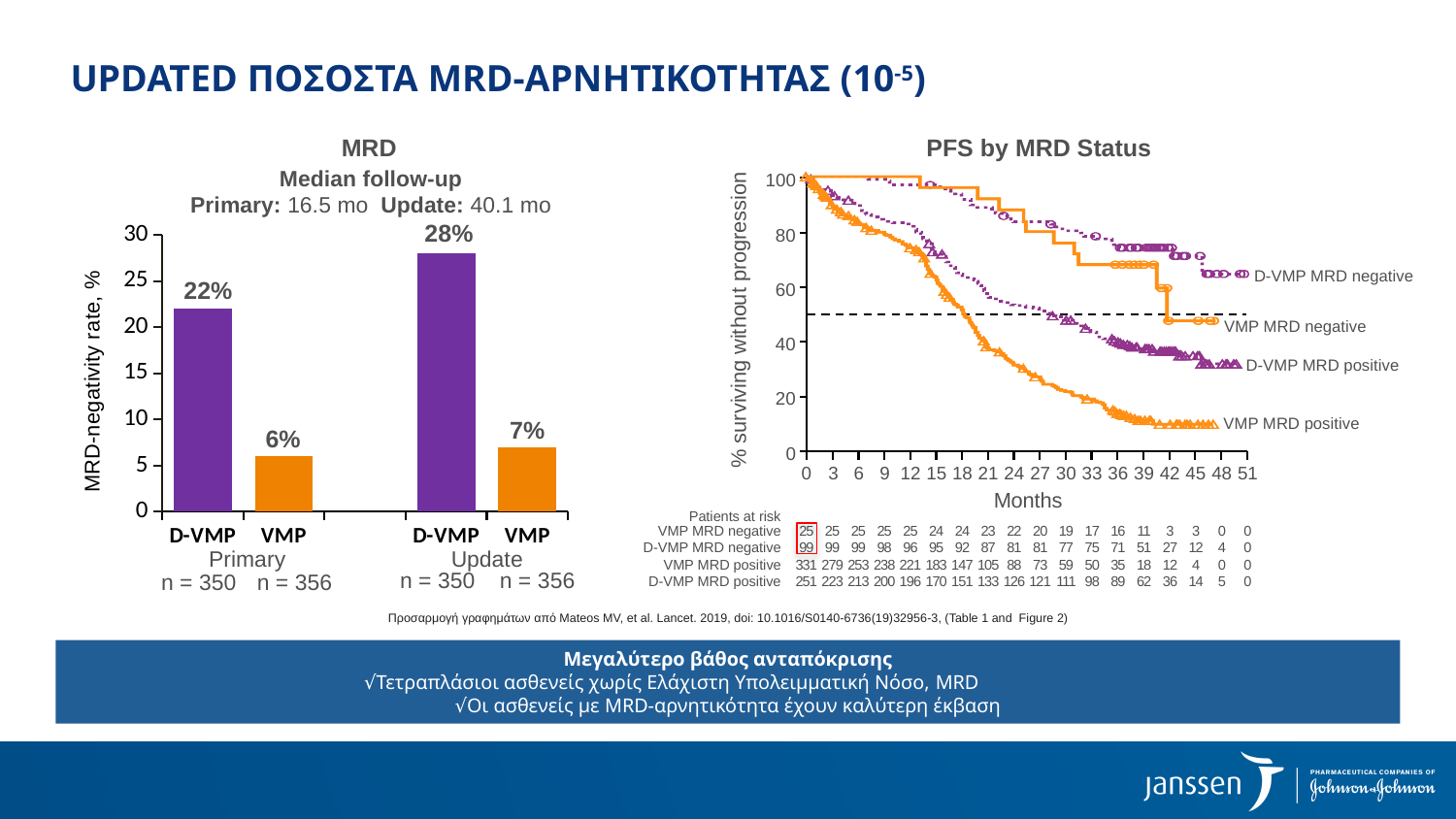
In the PFS by MRD Status chart, how many curves (groups) are plotted? 4 In the MRD bar chart, which bar has the lowest MRD-negativity rate? VMP (Primary) In the MRD bar chart, which is larger: the D-VMP rate in the Primary analysis or the D-VMP rate in the Update analysis? D-VMP Update In the PFS by MRD Status chart, is the value for VMP MRD positive at 24 months greater or less than 40? less In the MRD bar chart, what is the difference between the D-VMP and VMP MRD-negativity rates in the Update analysis? 21% In the MRD bar chart, which bar has the highest MRD-negativity rate? D-VMP (Update) In the PFS by MRD Status chart, how many patients were at risk in the VMP MRD positive group at 0 months? 331 How many bars are plotted in the MRD bar chart? 4 What type of chart is the MRD chart on the left of the slide? Bar chart In the PFS by MRD Status chart, is the value for D-VMP MRD negative at 24 months greater or less than 80? greater In the MRD bar chart, what is the MRD-negativity rate for D-VMP in the Primary analysis? 22% In the MRD bar chart, what is the MRD-negativity rate for VMP in the Update analysis? 7%